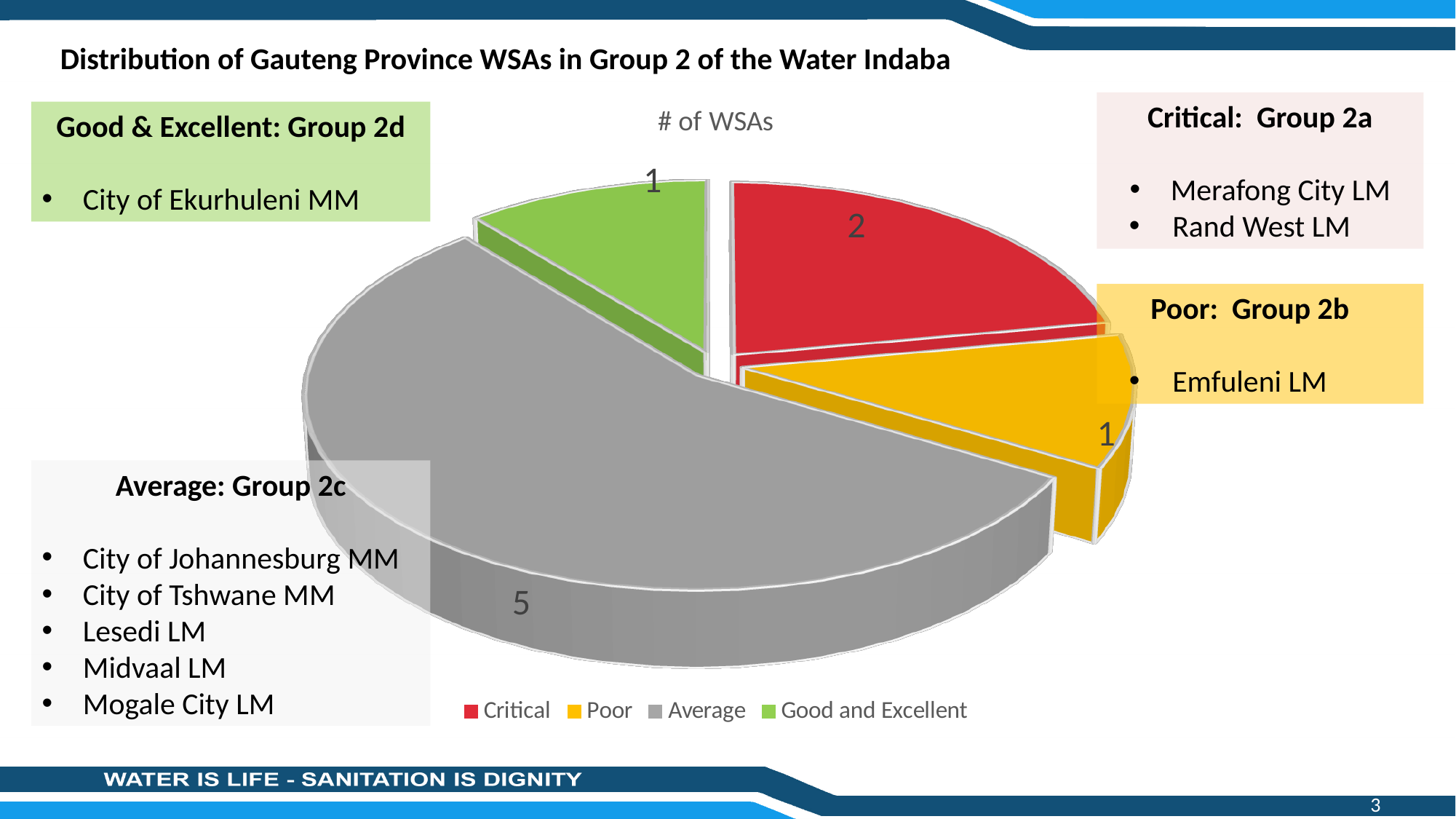
How many slices does the pie chart have? 4 What is the value for the Average slice? 5 What is the value for the Good and Excellent slice? 1 What is the difference between the Average and Critical values? 3 What is the value for the Critical slice? 2 What is the total number of WSAs across all slices of the pie? 9 What is the value for the Poor slice? 1 What kind of chart is shown on the slide? pie chart What is the title of the chart? # of WSAs Which legend entry is shown in grey? Average Which category has the largest slice of the pie? Average Which is larger, the Critical slice or the Poor slice? Critical